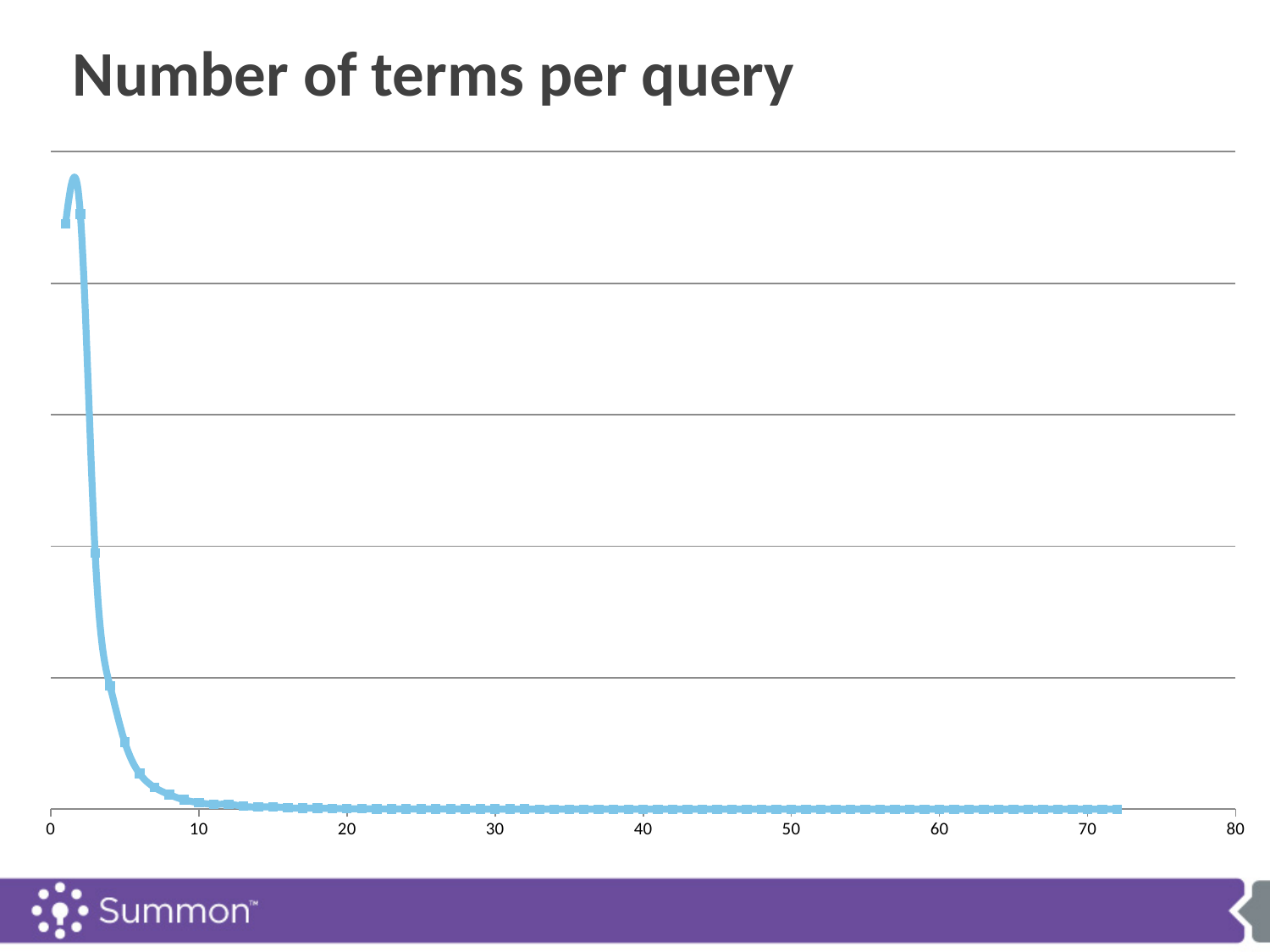
Does the plotted line reach the 80 tick on the x axis? no After its peak, do the values of the line rise or fall as the x axis increases? fall Does the plotted line extend past the 70 tick on the x axis? yes How many lines (series) are plotted on the chart? 1 What kind of chart is shown on the slide? line chart How many tick labels are shown on the x axis? 9 Which has the larger value on the line: the point at x = 5 or the point at x = 40? the point at x = 5 Is the peak of the line located at an x value greater or less than 10? less What is the highest value labelled on the x axis? 80 Which has the larger value on the line: the point near x = 2 or the point at x = 10? the point near x = 2 What is the title of the chart? Number of terms per query